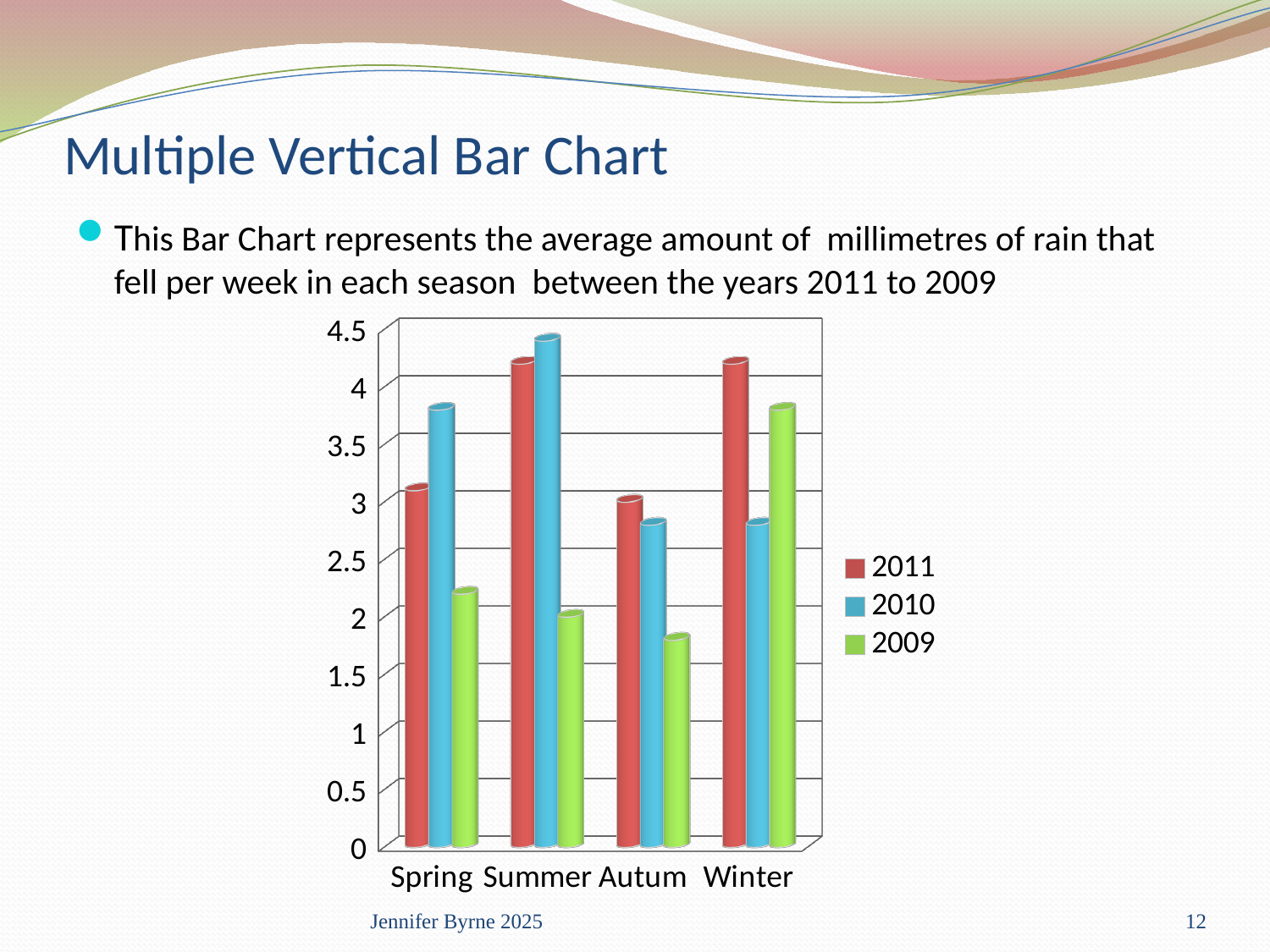
Which season has the highest value for the 2009 series? Winter Is the value for Winter in 2011 greater or less than 4? greater What colour are the bars for the 2009 series? green How many series does the chart's legend list? 3 Is the value for Summer in 2010 greater or less than 4? greater Is the value for Spring in 2009 greater or less than 2.5? less Which years are listed in the chart's legend? 2011, 2010, 2009 How many seasons are shown on the x axis of the chart? 4 What kind of chart is shown on the slide? bar chart Which season has the highest value for the 2010 series? Summer